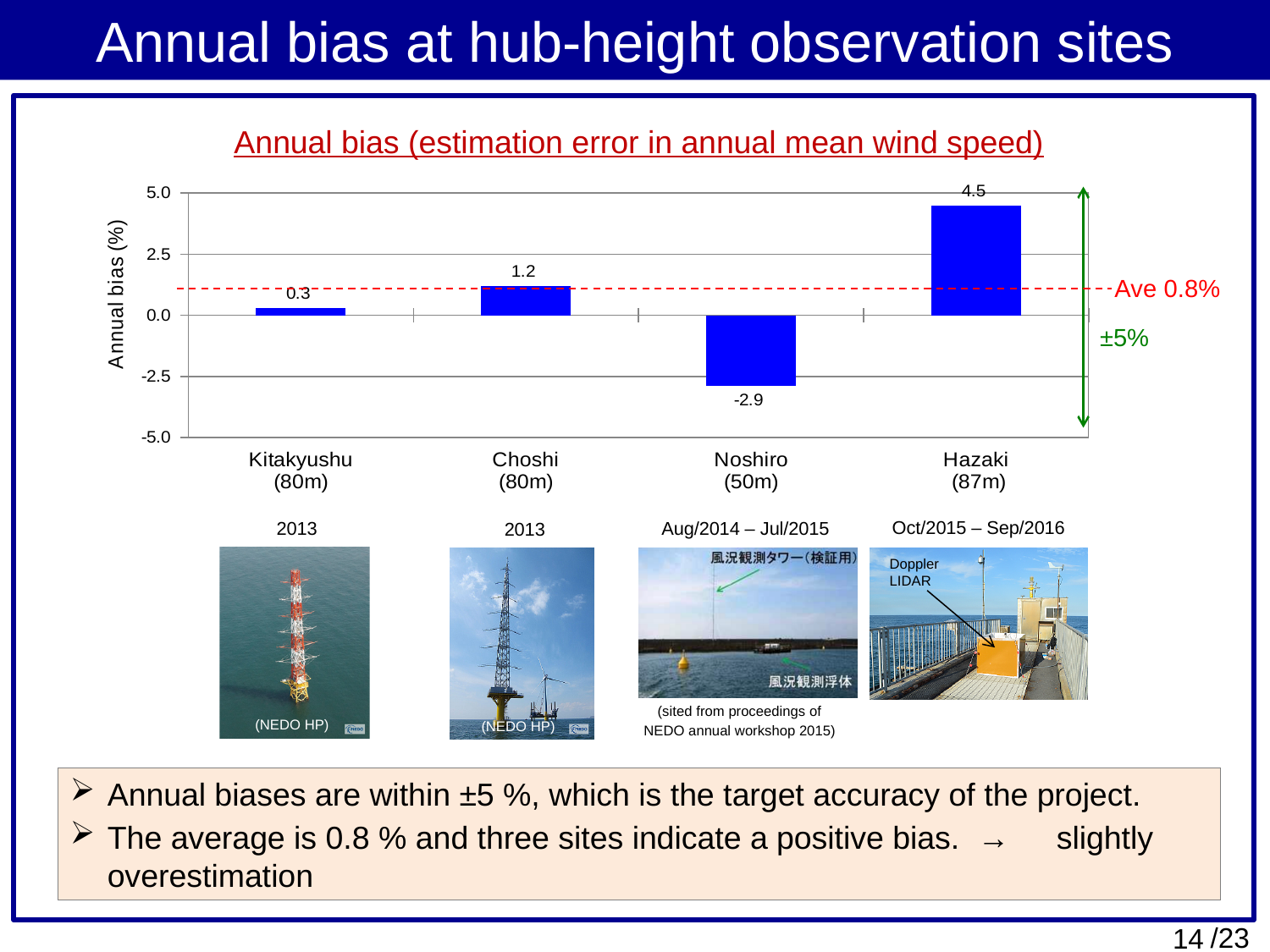
What is the annual bias for Noshiro (50m)? -2.9 Which site has a larger annual bias, Kitakyushu or Choshi? Choshi What is the annual bias for Hazaki (87m)? 4.5 What average value is marked by the red dashed line on the chart? Ave 0.8% What is the difference between the annual bias at Hazaki and at Choshi? 3.3 What is the annual bias for Choshi (80m)? 1.2 Which site has the highest annual bias? Hazaki (87m) What is the label on the y-axis of the chart? Annual bias (%) What is the annual bias for Kitakyushu (80m)? 0.3 How many observation sites are shown in the chart? 4 Which site has the lowest annual bias? Noshiro (50m) What type of chart is used to show the annual bias? Bar chart